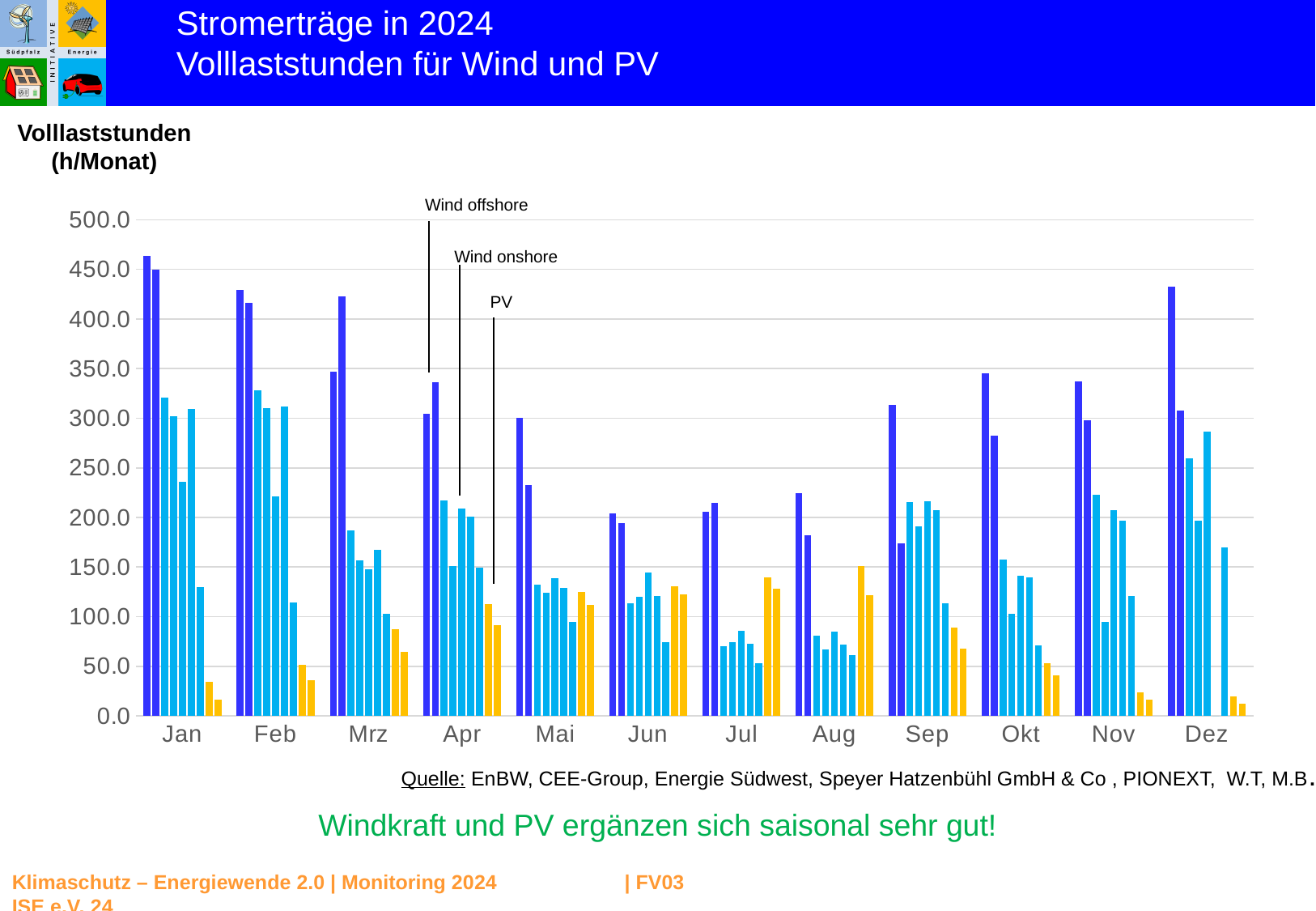
Is the tallest Wind offshore bar in Jan greater or less than 400? greater What kind of chart is shown on the slide? bar chart Is the tallest PV bar in Jul greater or less than 100? greater Which colour are the PV bars in the chart? yellow Do the PV bars rise or fall from Jan to Jun? rise Are the PV bars in Jan greater or less than 50? less Which is taller: the tallest Wind offshore bar in Jan or the tallest Wind offshore bar in Feb? Jan How many months are shown along the x axis of the chart? 12 What is the unit shown for the y axis of the chart? h/Monat How many series are labelled on the chart (Wind offshore, Wind onshore, PV)? 3 In which month does the tallest Wind offshore bar of the whole chart occur? Jan